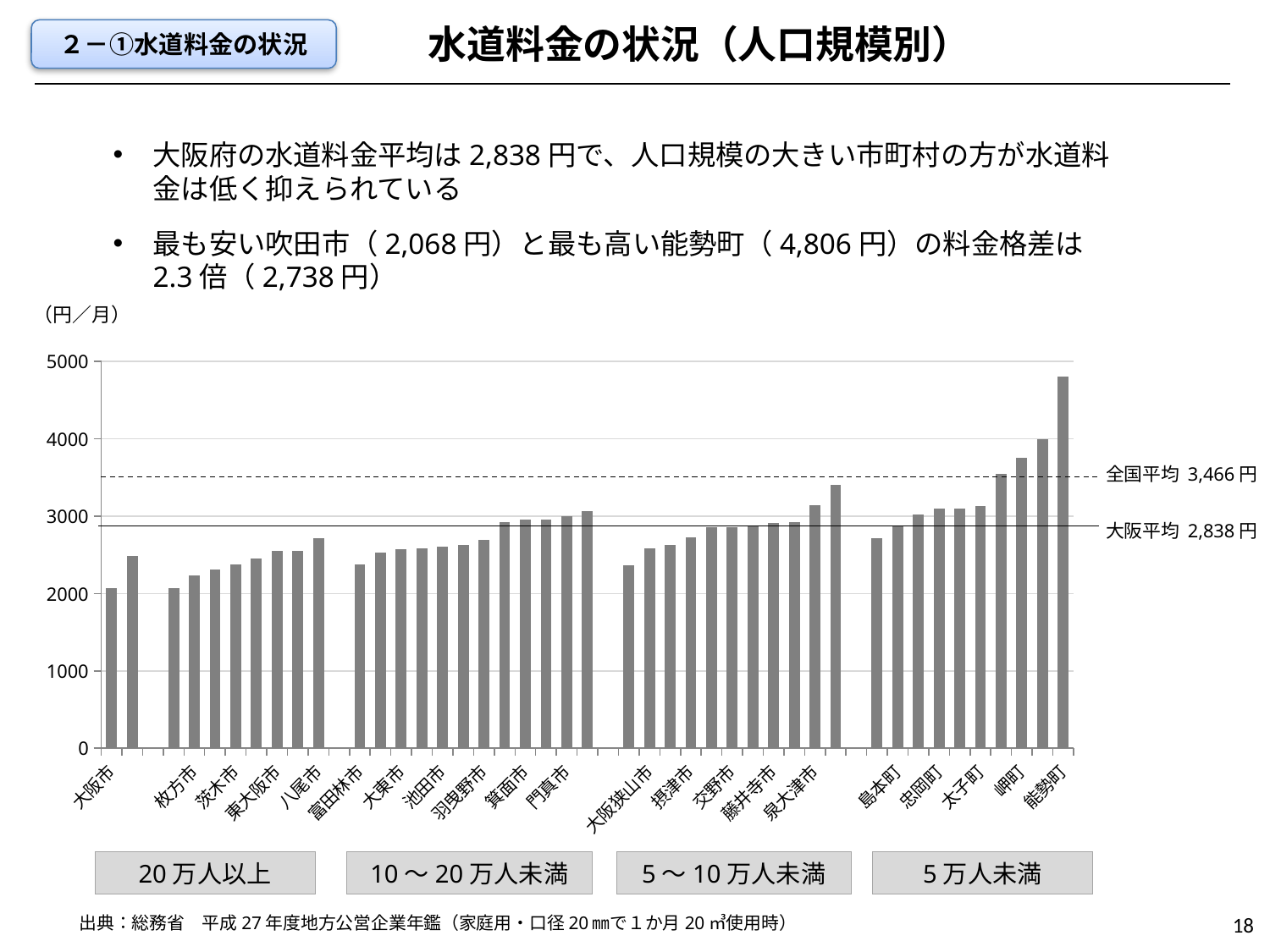
What is the difference between the 全国平均 (3,466円) and the 大阪平均 (2,838円)? 628円 Within the 20万人以上 group, do the bars rise or fall from left to right? rise Which municipality has the highest bar in the chart? 能勢町 Is the value for 大阪市 greater or less than 3000? less Is the value for 能勢町 greater or less than 4000? greater Is the value for 泉大津市 greater or less than 3000? greater Which is higher, the 全国平均 line or the 大阪平均 line? 全国平均 What kind of chart is shown on the slide? bar chart How many population-size groups are labeled below the chart? 4 What value is shown for the 全国平均 reference line? 3,466円 Which has the larger value, 泉大津市 or 島本町? 泉大津市 What value is shown for the 大阪平均 reference line? 2,838円